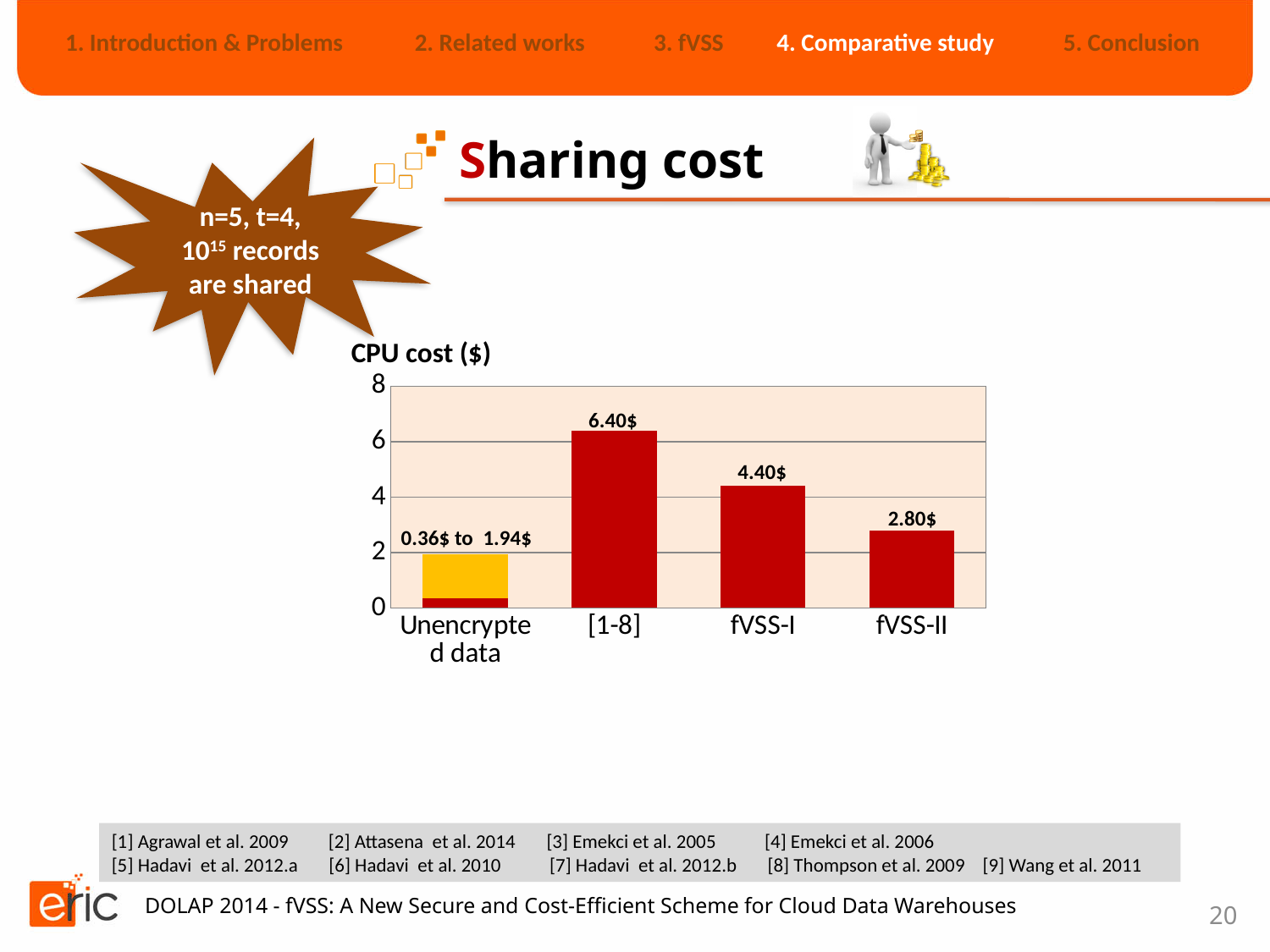
Which category has the highest CPU cost? [1-8] What kind of chart is shown on the slide? bar chart Which has a higher CPU cost, fVSS-I or fVSS-II? fVSS-I What is the difference in CPU cost between [1-8] and fVSS-I? 2.00$ What range of CPU cost is labelled for Unencrypted data? 0.36$ to 1.94$ How many categories are shown on the x axis of the chart? 4 What is the CPU cost shown for fVSS-I? 4.40$ Is the CPU cost for [1-8] greater or less than 6? greater What is the CPU cost shown for fVSS-II? 2.80$ What is the CPU cost shown for [1-8]? 6.40$ Which category has the lowest CPU cost? Unencrypted data What is the difference in CPU cost between fVSS-I and fVSS-II? 1.60$